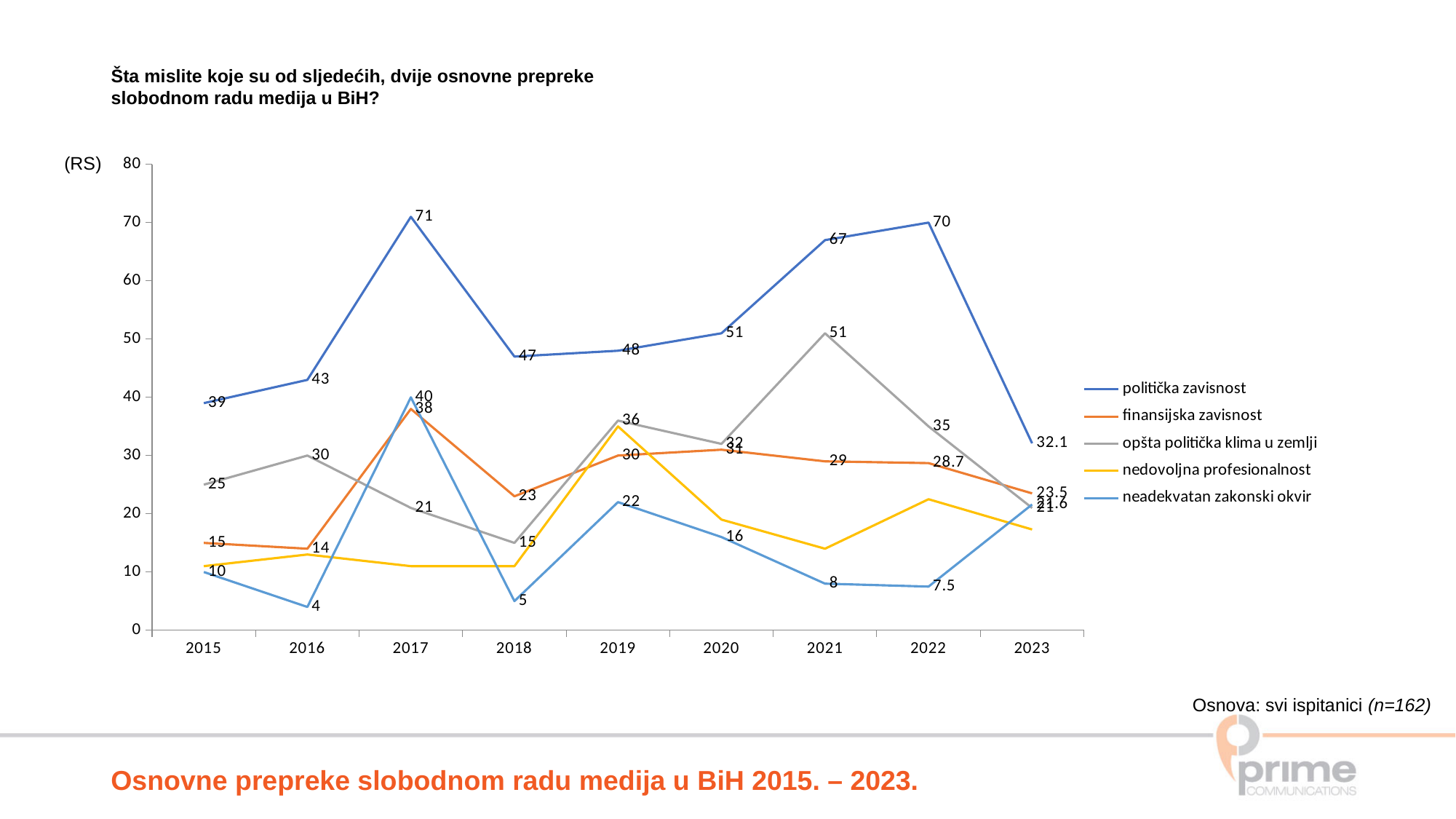
How many years are plotted along the x axis? 9 What is the value for politička zavisnost in 2023? 32.1 What is the value for neadekvatan zakonski okvir in 2022? 7.5 What kind of chart is shown on the slide? line chart Is the value for nedovoljna profesionalnost in 2019 greater or less than 30? greater How many series does the legend list? 5 What is the value for politička zavisnost in 2017? 71 What is the difference between politička zavisnost in 2017 and in 2018? 24 What is the value for opšta politička klima u zemlji in 2021? 51 In 2021, which is larger: opšta politička klima u zemlji or finansijska zavisnost? opšta politička klima u zemlji In which year is politička zavisnost at its lowest? 2023 What is the value for finansijska zavisnost in 2017? 38